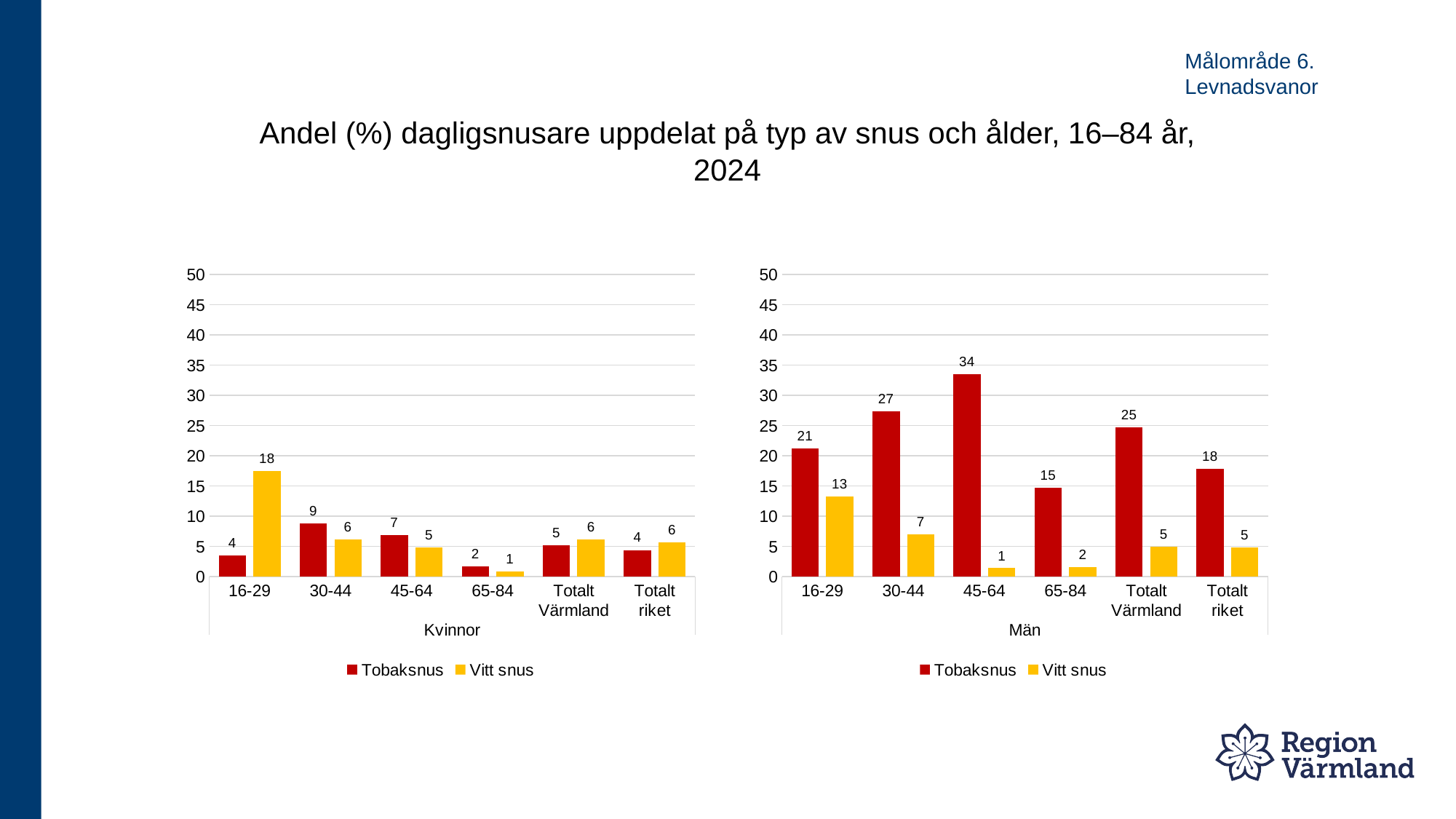
In the Män chart, what is the value for Tobaksnus in the 45-64 age group? 34 In the Män chart, what is the difference between the Tobaksnus values for 45-64 and 65-84? 19 In the Män chart, is the Tobaksnus value for 30-44 greater or less than 25? greater How many categories are shown on the x axis of the Kvinnor chart? 6 In the Kvinnor chart, what colour are the Vitt snus bars? Yellow How many series does the legend of the Män chart list? 2 In the Kvinnor chart, what is the value for Vitt snus in the 16-29 age group? 18 In the Män chart, what is the value for Vitt snus for Totalt Värmland? 5 In the Kvinnor chart, which is larger for the 16-29 age group, Tobaksnus or Vitt snus? Vitt snus In the Män chart, which age group has the lowest Vitt snus value? 45-64 What kind of chart is the Kvinnor chart? Bar chart In the Kvinnor chart, which age group has the highest Tobaksnus value? 30-44